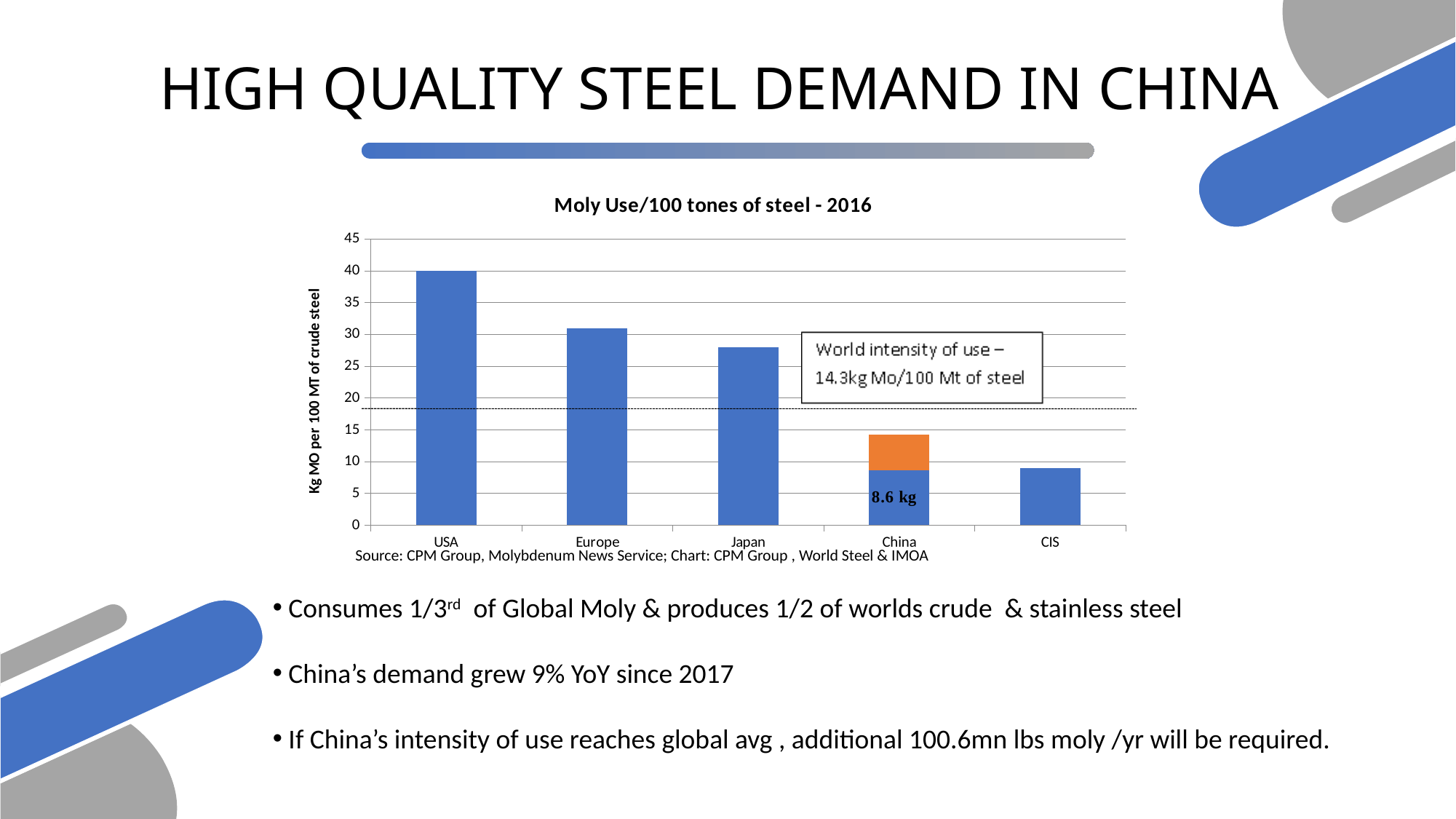
Is the value for Europe greater or less than 35? less What value is labelled on the China bar? 8.6 kg What is the title of the chart? Moly Use/100 tones of steel - 2016 What is the value for the USA in the chart? 40 Which has a higher value, Europe or Japan? Europe What is the difference between the USA value and the labelled China value? 31.4 kg Is the value for CIS greater or less than 15? less What kind of chart is shown on the slide? bar chart Which country or region has the highest moly use per 100 tonnes of steel? USA How many countries or regions are shown on the x axis of the chart? 5 What world intensity of use is stated in the box on the chart? 14.3kg Mo/100 Mt of steel Is the value for Japan greater or less than 25? greater